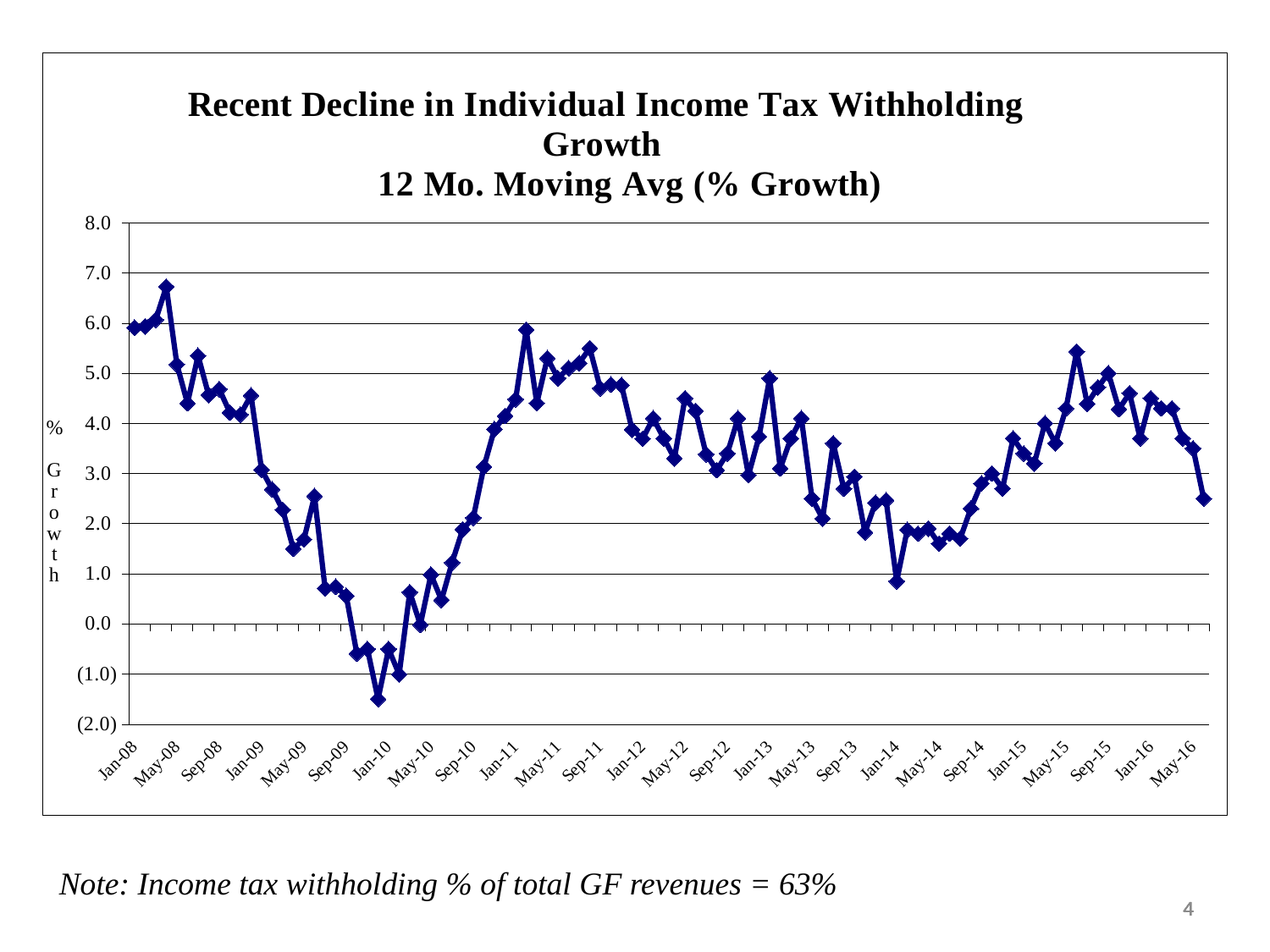
Is the last plotted value (mid-2016) greater or less than 3.0? less Is the value for Jan-10 greater or less than 0.0? less Is the highest value on the chart greater or less than 6.0? greater Do the values rise or fall between Jan-08 and Jan-10? fall Do the values rise or fall between Jan-10 and Jan-11? rise Around which x-axis label does the lowest value on the chart occur? Jan-10 What is the label on the vertical axis of the chart? % Growth What is the title of the chart? Recent Decline in Individual Income Tax Withholding Growth 12 Mo. Moving Avg (% Growth) What kind of chart is shown on the slide? line chart